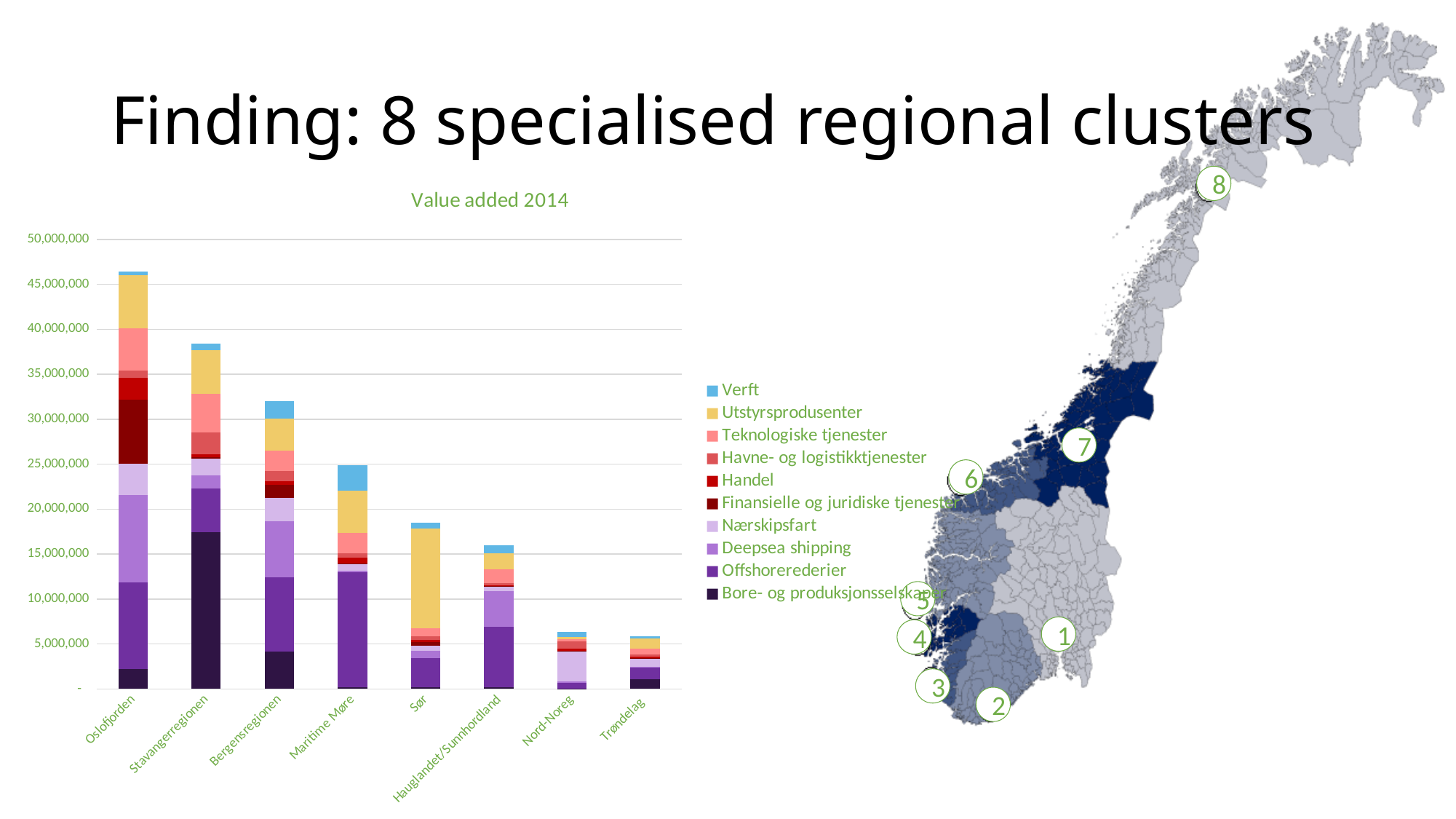
Which series is listed first in the chart legend? Verft What is the title of the chart? Value added 2014 Which region has the highest total value added in the chart? Oslofjorden What kind of chart is shown on the slide? Stacked bar chart Is the total value for Stavangerregionen greater or less than 35,000,000? greater Do the total values generally rise or fall moving from left to right along the x axis? fall Is the total value for Sør greater or less than 20,000,000? less How many regions (categories) are shown on the x axis of the chart? 8 Which has a larger total value added, Stavangerregionen or Bergensregionen? Stavangerregionen Is the total value for Nord-Noreg greater or less than 10,000,000? less How many series does the chart legend list? 10